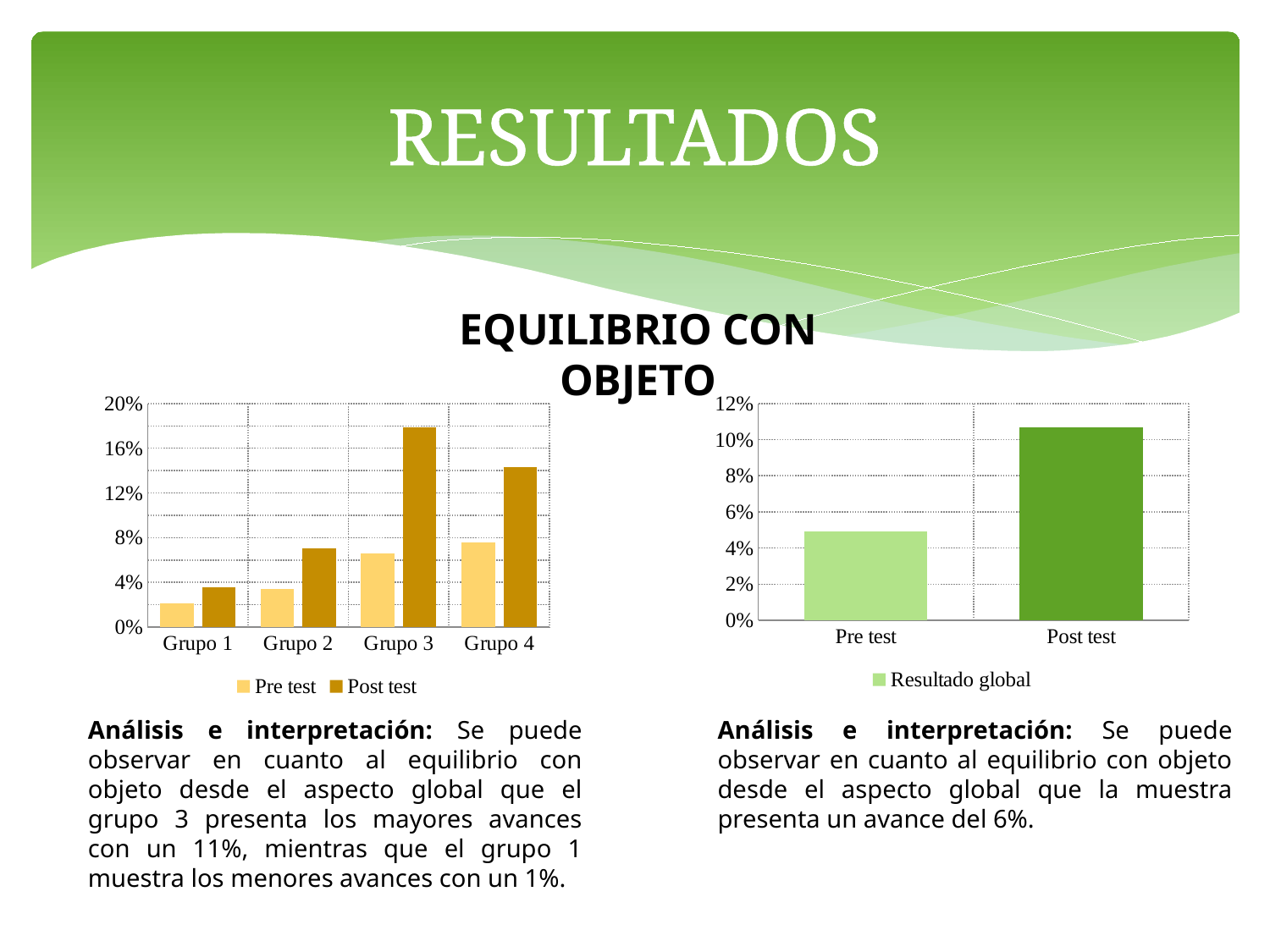
In the left chart, which is larger for Grupo 4: the Pre test value or the Post test value? Post test In the left chart, which group has the lowest Pre test value? Grupo 1 How many series does the legend of the left chart list? 2 How many groups are shown on the x axis of the left chart? 4 In the left chart, which group has the highest Post test value? Grupo 3 What kind of chart is the left chart on the slide? bar chart In the right chart, which is larger: Pre test or Post test? Post test In the right chart, is the Post test value greater or less than 10%? greater What kind of chart is the right chart on the slide? bar chart In the left chart, is the Post test value for Grupo 1 greater or less than 4%? less What series name does the legend of the right chart show? Resultado global In the left chart, is the Post test value for Grupo 3 greater or less than 16%? greater